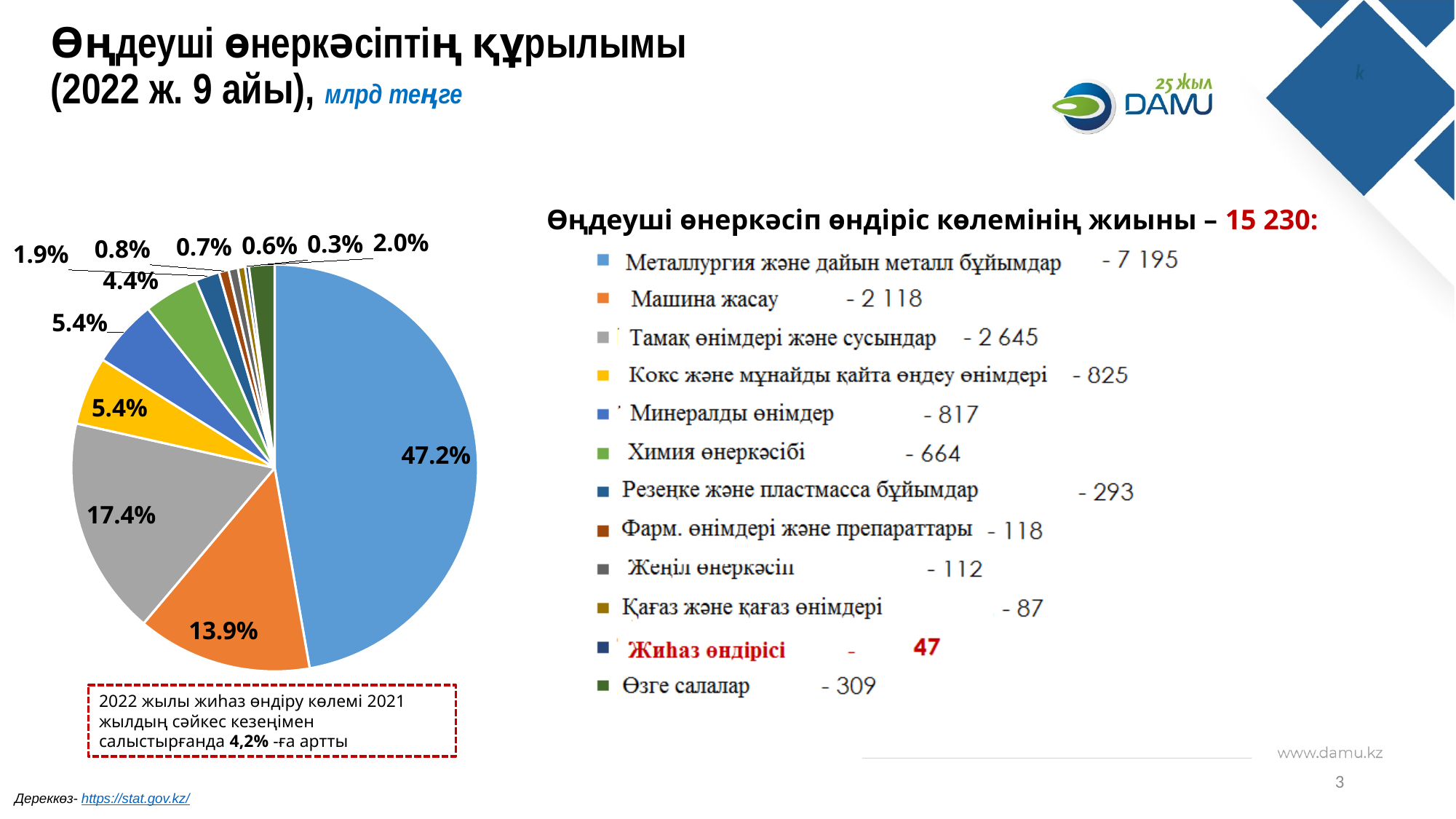
What is the value listed for Машина жасау? 2 118 What share of the pie does the largest slice represent? 47.2% Which category has the largest share of the pie chart? Металлургия және дайын металл бұйымдар How many slices does the pie chart have? 12 What is the difference between the values for Тамақ өнімдері және сусындар and Машина жасау? 527 What kind of chart is shown on the slide? pie chart What is the value listed for Тамақ өнімдері және сусындар? 2 645 What is the total volume of manufacturing production stated on the slide? 15 230 Which category has the smallest share of the pie chart? Жиһаз өндірісі What is the value listed for Жиһаз өндірісі? 47 What share of the pie does Химия өнеркәсібі represent? 4.4% Which is larger, the value for Кокс және мұнайды қайта өңдеу өнімдері or the value for Минералды өнімдер? Кокс және мұнайды қайта өңдеу өнімдері